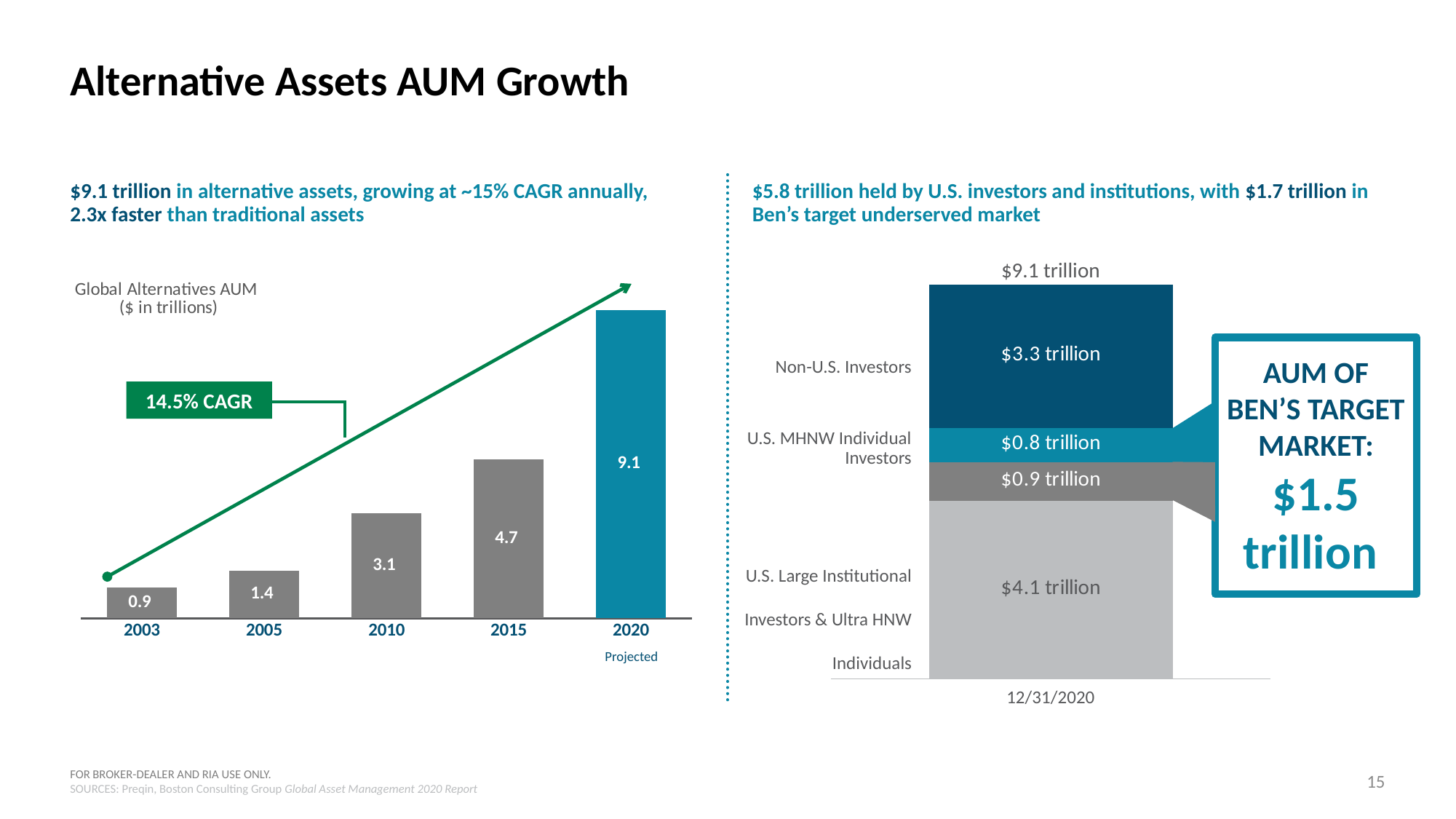
What kind of chart is the Global Alternatives AUM chart on the left? bar chart In the Global Alternatives AUM chart on the left, what CAGR is shown in the green label? 14.5% CAGR In the stacked bar chart on the right, what is the value for Non-U.S. Investors? $3.3 trillion In the Global Alternatives AUM chart on the left, which year has the highest value? 2020 In the stacked bar chart on the right, what is the value for U.S. Large Institutional Investors & Ultra HNW Individuals? $4.1 trillion In the Global Alternatives AUM chart on the left, how many years are shown on the x axis? 5 In the Global Alternatives AUM chart on the left, what is the value for 2010? 3.1 In the Global Alternatives AUM chart on the left, which year has the lowest value? 2003 In the stacked bar chart on the right, what is the total of the stacked bar? $9.1 trillion In the Global Alternatives AUM chart on the left, what is the difference between the 2020 and 2015 values? 4.4 In the Global Alternatives AUM chart on the left, what is the value for 2003? 0.9 In the Global Alternatives AUM chart on the left, do the values rise or fall from 2003 to 2020? rise